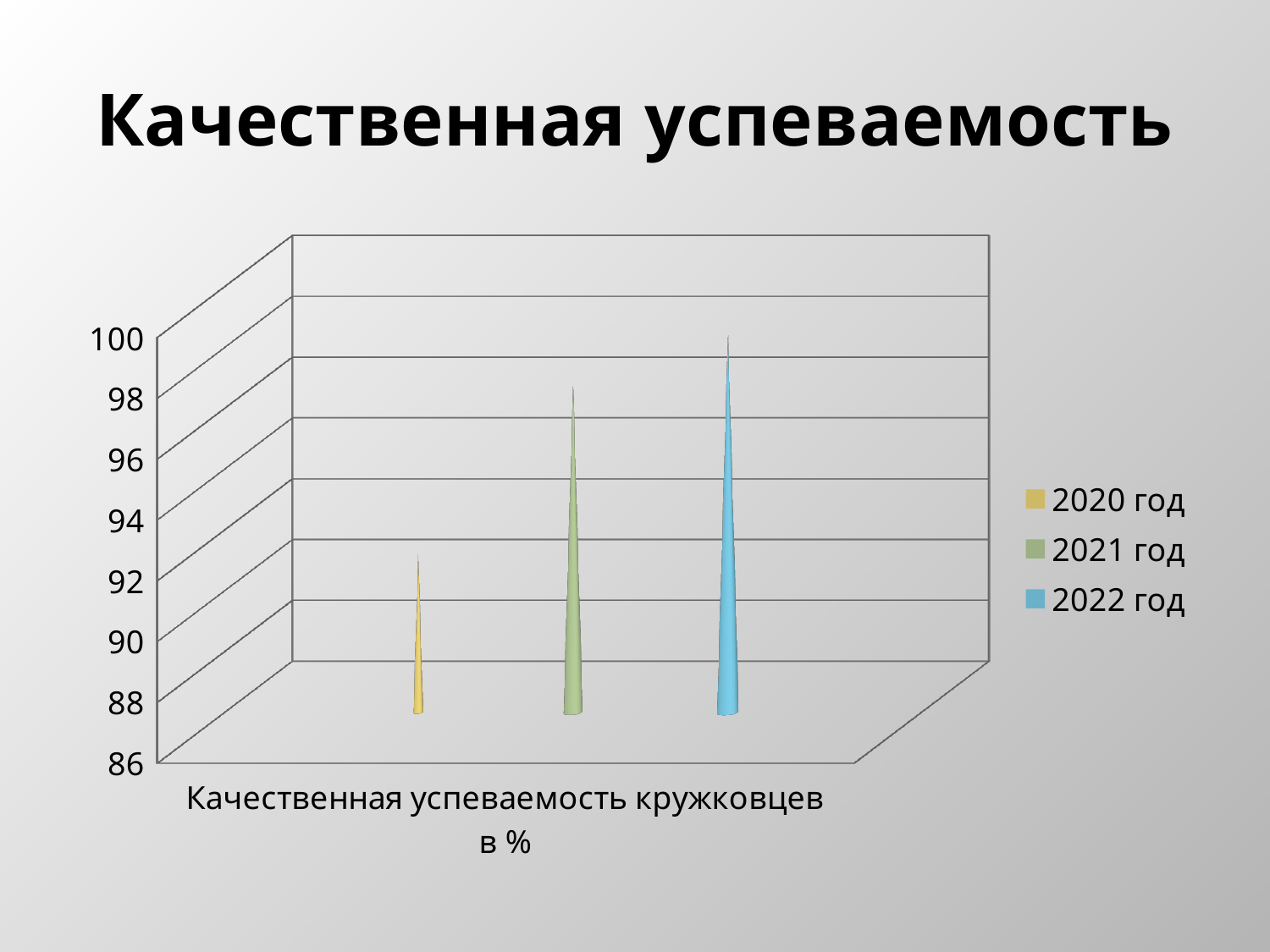
Which is larger, the value for 2021 год or the value for 2020 год? 2021 год Is the value for 2021 год greater or less than 94? greater Is the value for 2020 год greater or less than 96? less Which series has the highest value in the chart? 2022 год How many categories are shown on the x axis? 1 Which series has the lowest value in the chart? 2020 год What colour represents 2022 год in the legend? blue Is the value for 2022 год greater or less than 96? greater What kind of chart is shown on the slide? bar chart Do the values rise or fall from 2020 год to 2022 год? rise How many series does the legend list? 3 What is the title of the slide? Качественная успеваемость